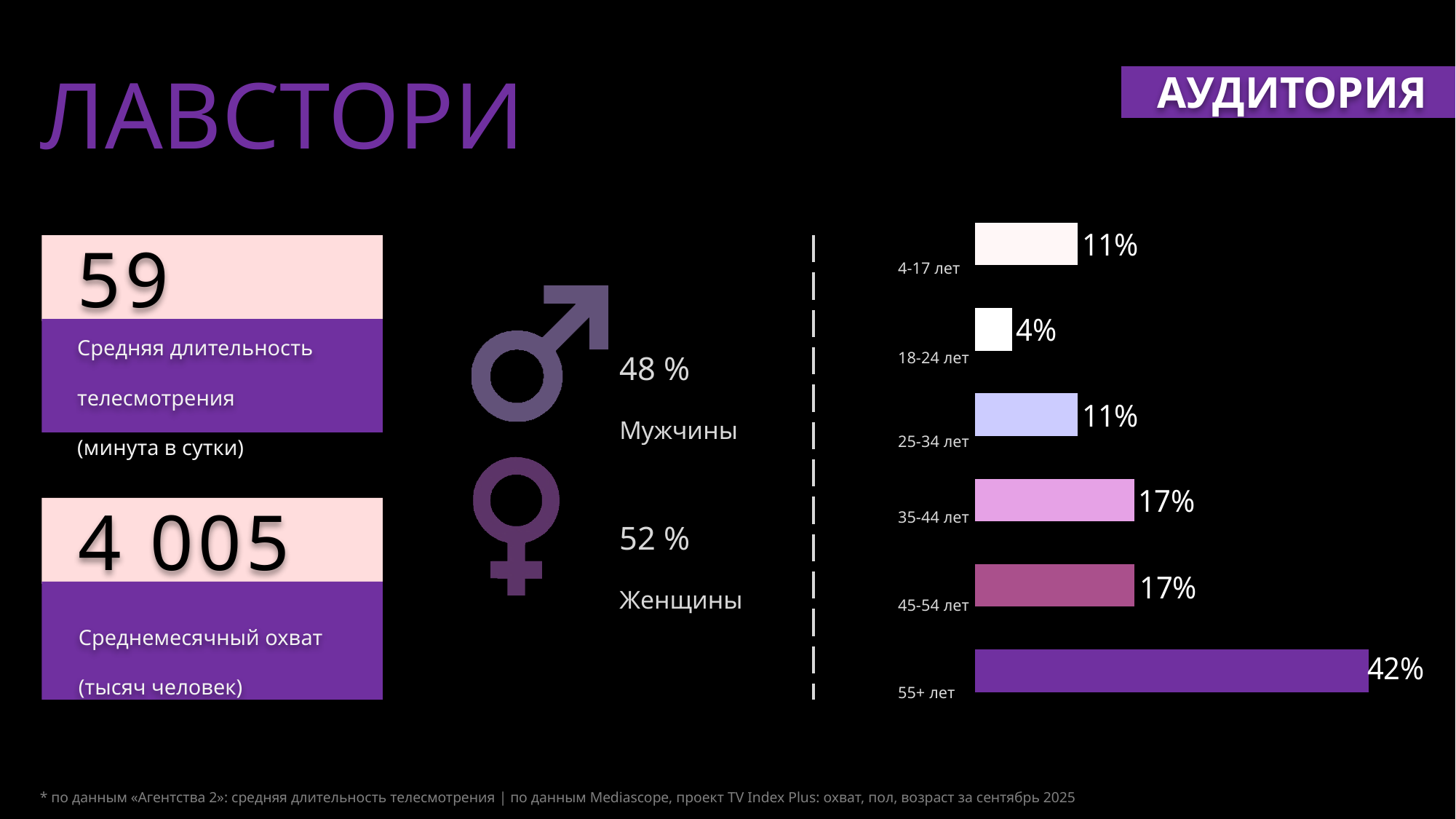
What kind of chart is used to show the age groups on the slide? Bar chart In the age-group bar chart, what is the value for 35-44 лет? 17% In the age-group bar chart, what is the value for 4-17 лет? 11% In the age-group bar chart, what is the difference between the values for 55+ лет and 45-54 лет? 25% In the age-group bar chart, what is the value for 18-24 лет? 4% In the age-group bar chart, which age group has the lowest value? 18-24 лет In the age-group bar chart, what is the value for 55+ лет? 42% In the age-group bar chart, which age group has the highest value? 55+ лет In the age-group bar chart, which is larger: the value for 35-44 лет or the value for 4-17 лет? 35-44 лет How many age groups are shown in the bar chart? 6 In the age-group bar chart, what is the difference between the values for 25-34 лет and 18-24 лет? 7% In the age-group bar chart, what is the combined value of 35-44 лет and 45-54 лет? 34%